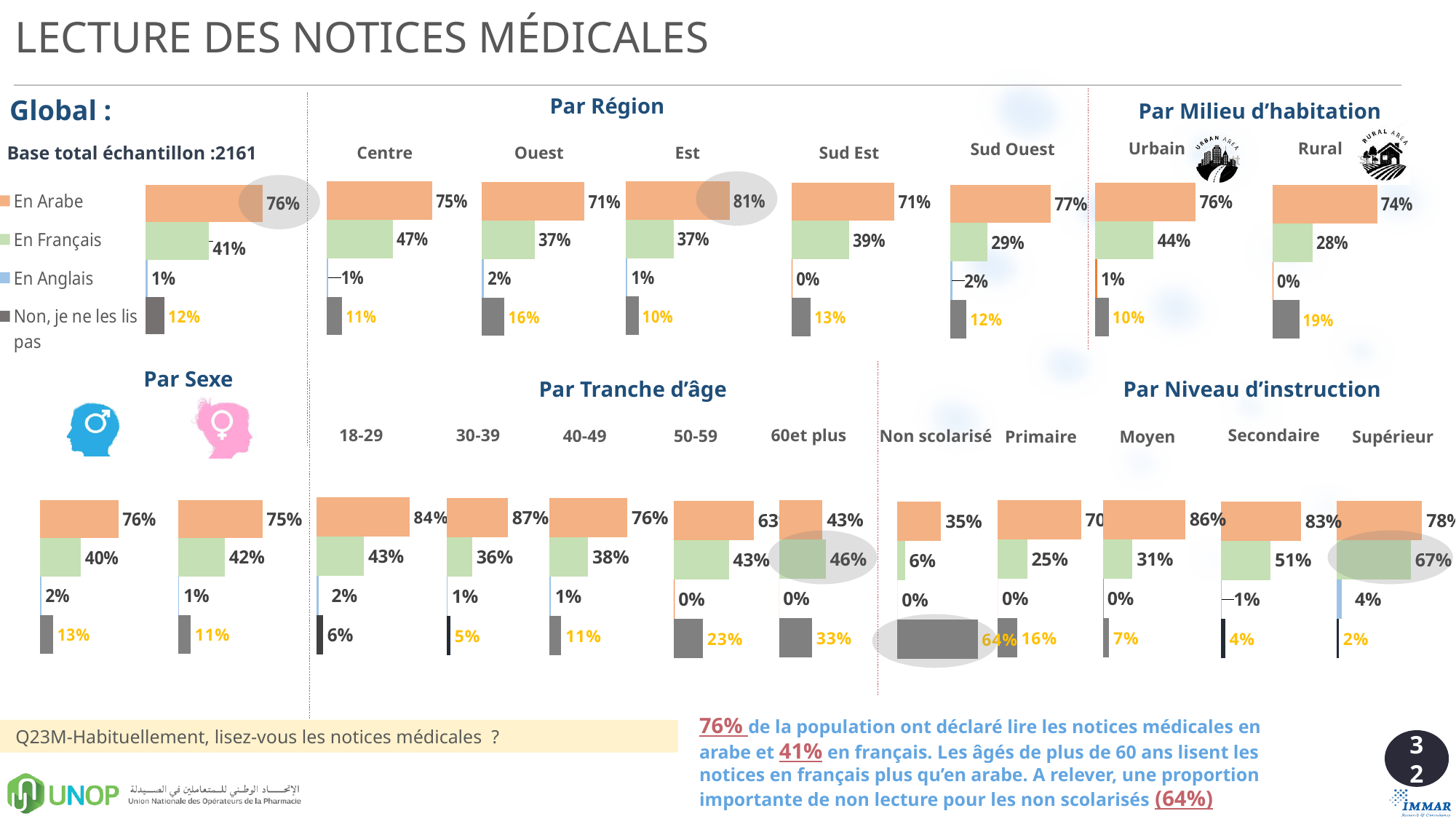
In the Global chart, what percentage read medical notices in Arabic (En Arabe)? 76% In the Par Tranche d'âge chart, which age group has the highest En Arabe value? 30-39 How many series does the legend of the Global chart list? 4 In the Par Tranche d'âge chart, what is the 'Non, je ne les lis pas' value for the 60 et plus group? 33% How many age groups are shown in the Par Tranche d'âge chart? 5 In the Global chart, what percentage answered 'Non, je ne les lis pas'? 12% In the Par Niveau d'instruction chart, what is the 'Non, je ne les lis pas' value for Non scolarisé? 64% In the Par Niveau d'instruction chart, which level has the highest En Français value? Supérieur In the Par Milieu d'habitation chart, which has the higher 'Non, je ne les lis pas' value, Urbain or Rural? Rural In the Par Région chart, what is the En Français value for Centre? 47% In the Par Milieu d'habitation chart, what is the difference between the Urbain and Rural values for En Français? 16% In the Par Région chart, which region has the highest percentage for En Arabe? Est